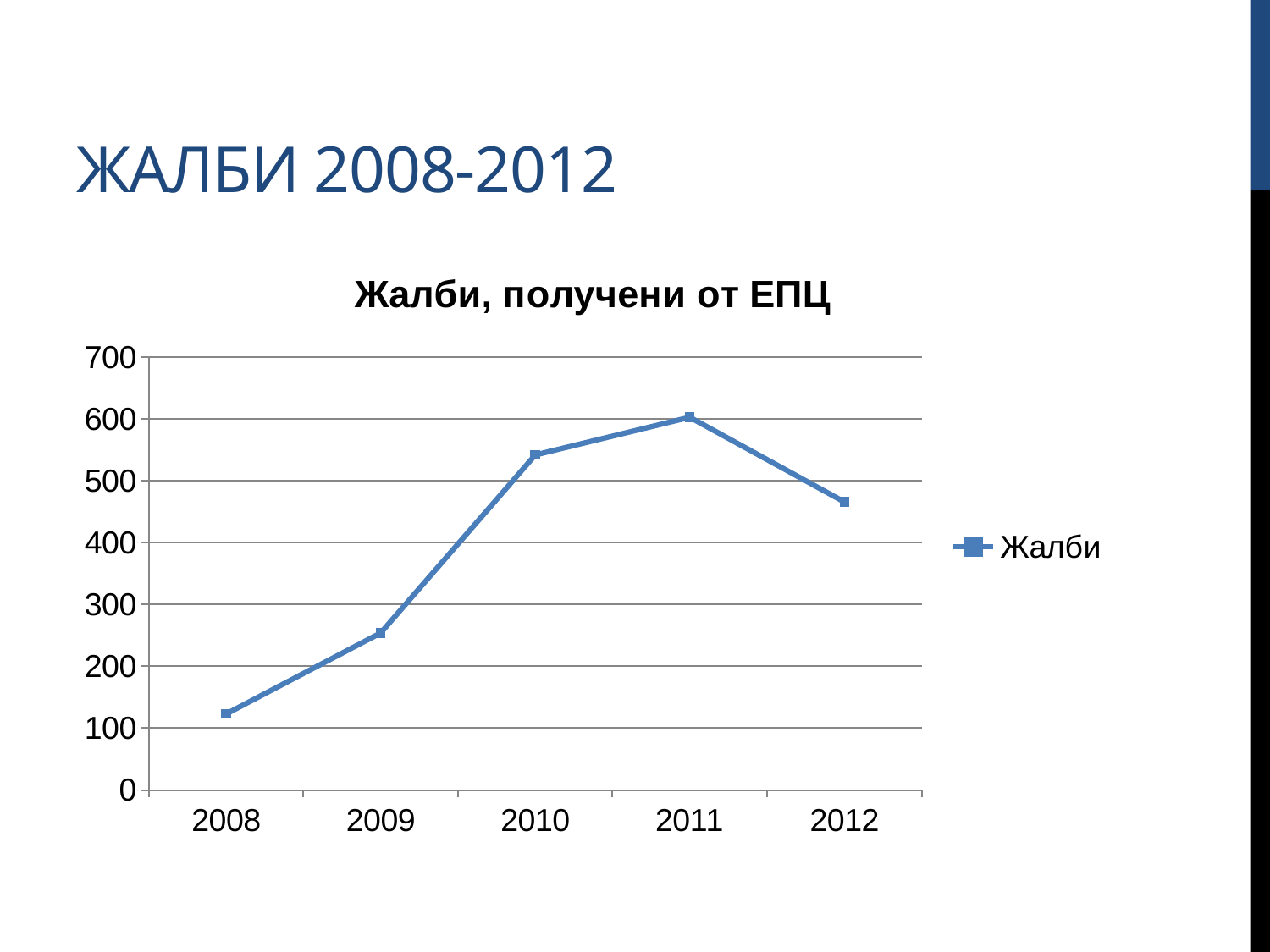
Is the value for 2009 greater or less than 300? less Which is larger, the value for 2010 or the value for 2012? 2010 Is the value for 2010 greater or less than 500? greater Is the value for 2008 greater or less than 100? greater What kind of chart is shown on the slide? line chart Which year has the lowest number of complaints (Жалби)? 2008 Do the values rise or fall from 2008 to 2011? rise How many series does the legend list? 1 Which year has the highest number of complaints (Жалби)? 2011 What is the title of the chart? Жалби, получени от ЕПЦ How many years are plotted on the x axis? 5